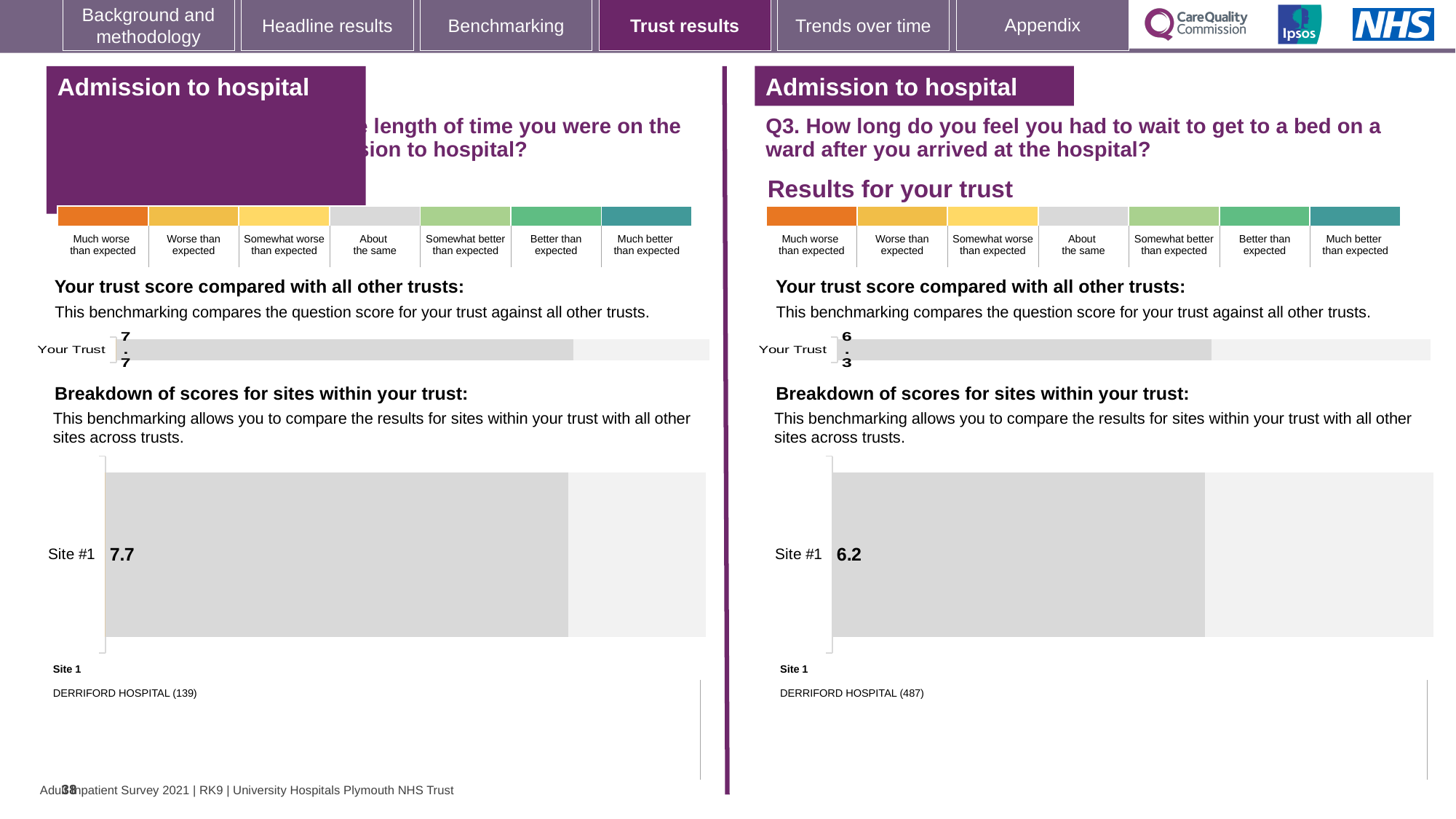
How many sites are shown in the right 'Breakdown of scores for sites within your trust' chart (Q3)? 1 In the left 'Breakdown of scores for sites within your trust' chart, what score is shown for Site #1? 7.7 On the left half of the slide, what is the score shown for 'Your Trust' in the trust benchmarking bar? 7.7 What is the difference between the Site #1 score on the left chart (7.7) and the Site #1 score on the right chart (6.2)? 1.5 What is the difference between the 'Your Trust' score on the right half (6.3) and the Site #1 score on the right half (6.2)? 0.1 In the right 'Breakdown of scores for sites within your trust' chart (Q3), what score is shown for Site #1? 6.2 What type of chart is used to show the Site #1 score on the right half of the slide? Bar chart How many sites are shown in the left 'Breakdown of scores for sites within your trust' chart? 1 On the right half of the slide (Q3), what is the score shown for 'Your Trust' in the trust benchmarking bar? 6.3 Which hospital is listed as Site 1 on the right half of the slide (Q3)? DERRIFORD HOSPITAL (487) Which is larger: the 'Your Trust' score on the left half of the slide or the 'Your Trust' score on the right half (Q3)? Left (7.7) What is the number in brackets after DERRIFORD HOSPITAL in the Site 1 listing on the left half of the slide? 139